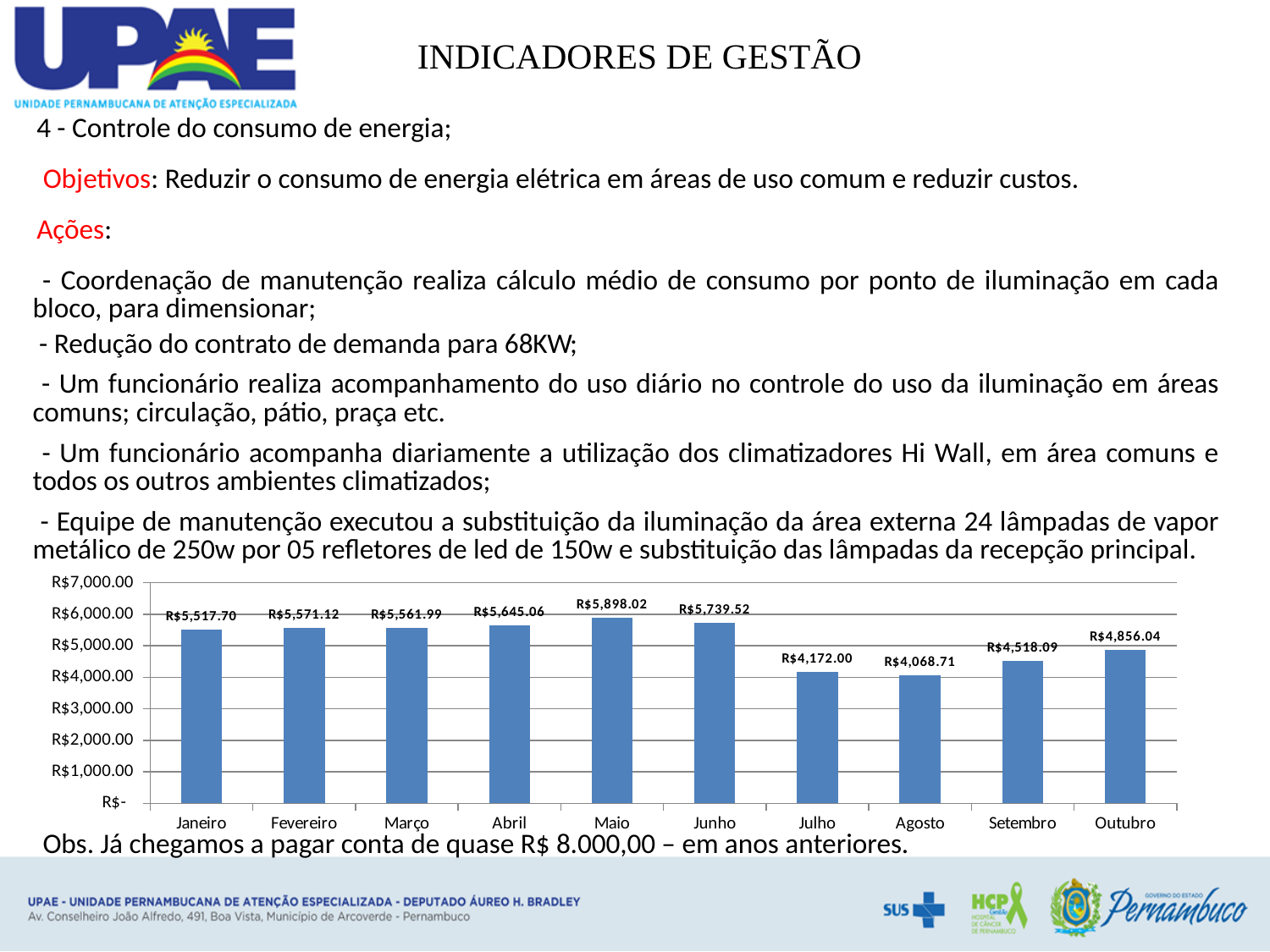
What kind of chart is shown on the slide? bar chart What is the difference between the values for Junho and Julho? R$1,567.52 Is the value for Julho greater or less than R$5,000.00? less How many months are shown on the x axis? 10 What is the value for Julho? R$4,172.00 What is the value for Janeiro? R$5,517.70 Do the values rise or fall from Maio to Agosto? fall Which is larger, the value for Setembro or the value for Outubro? Outubro What is the difference between the values for Maio and Agosto? R$1,829.31 What is the value for Outubro? R$4,856.04 Which month has the lowest value? Agosto Which month has the highest value? Maio